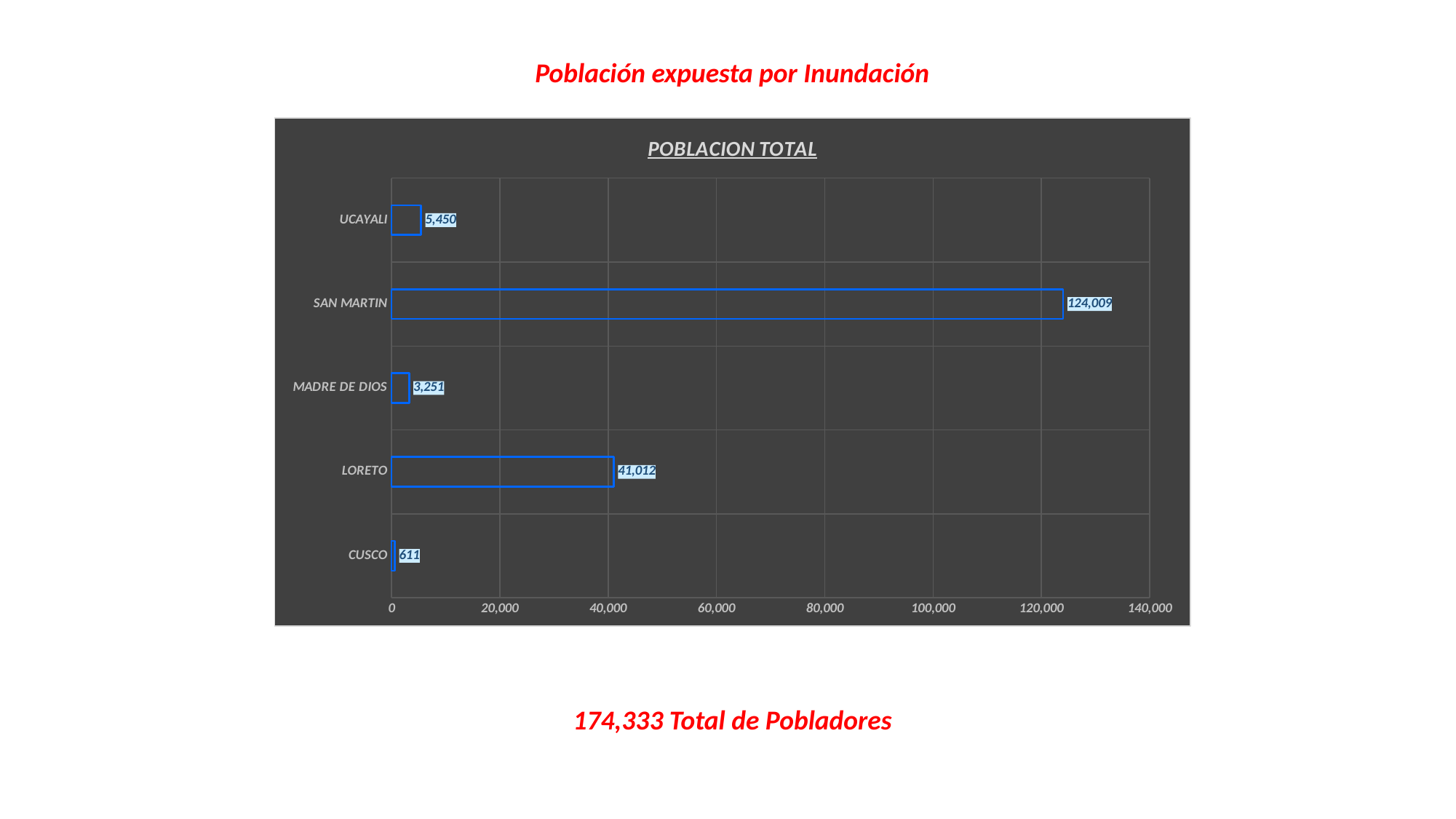
What is the value for UCAYALI? 5,450 What kind of chart is shown? bar chart What is the title of the chart? POBLACION TOTAL How many categories are shown in the chart? 5 Is the value for LORETO greater or less than 40,000? greater Which category has the highest value? SAN MARTIN Which category has the lowest value? CUSCO What is the difference between the values for SAN MARTIN and LORETO? 82,997 What is the value for LORETO? 41,012 What is the value for MADRE DE DIOS? 3,251 What is the value for SAN MARTIN? 124,009 Which is larger, the value for UCAYALI or the value for MADRE DE DIOS? UCAYALI